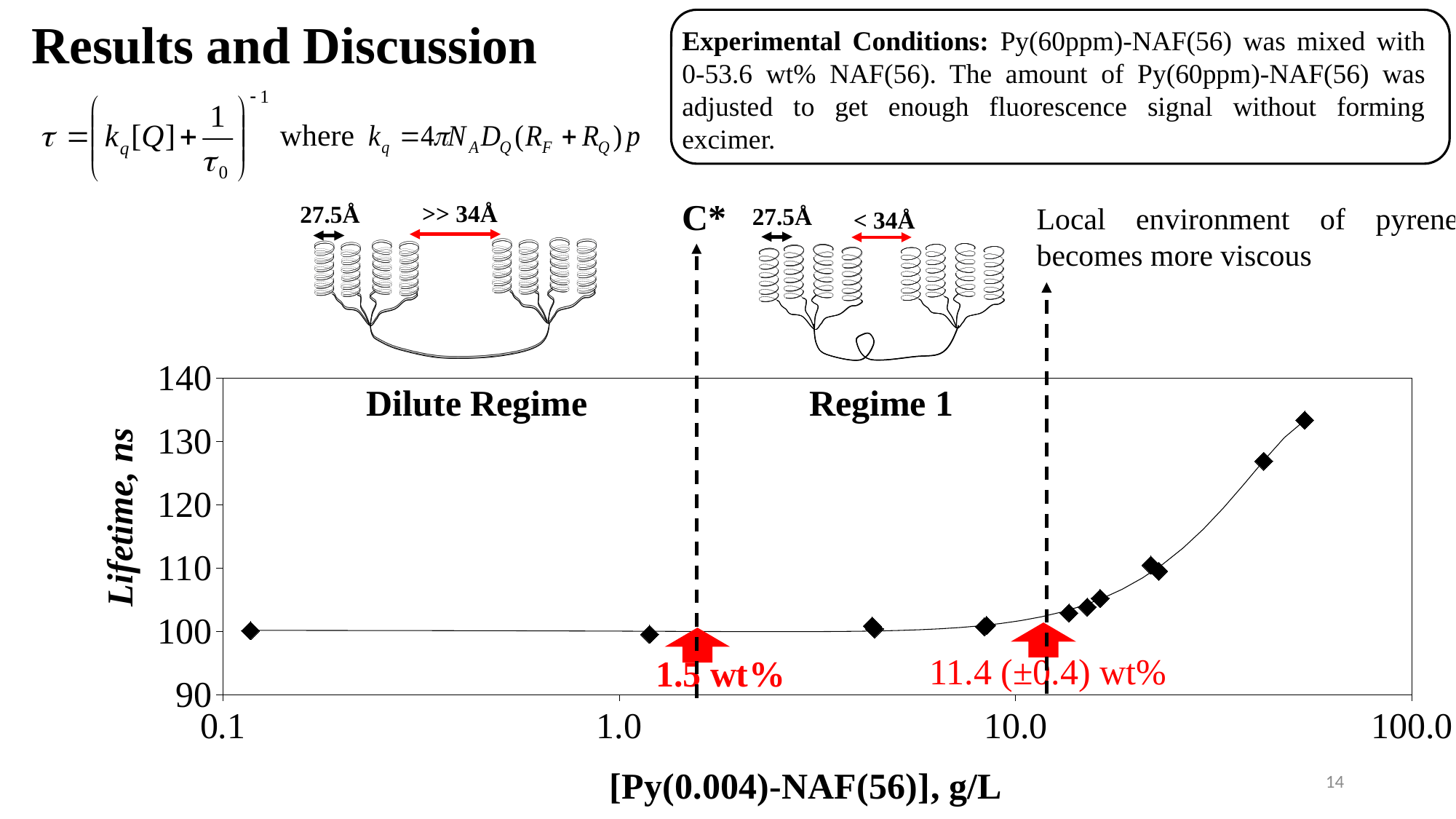
Does the lifetime rise or fall as the concentration increases beyond about 10 g/L? rise Is the lifetime at the second-highest concentration point greater or less than 120 ns? greater What is the highest value shown on the x axis of the chart? 100.0 What is the lowest value shown on the y axis of the chart? 90 Is the lifetime at the point just above 1.0 g/L greater or less than 110 ns? less Is the lifetime at the highest plotted concentration greater or less than 130 ns? greater What are the two regimes labelled on the chart? Dilute Regime and Regime 1 What kind of chart is shown on the slide? Scatter (line) chart Which has the larger lifetime: the point at about 0.1 g/L or the point at the highest concentration? the point at the highest concentration What is the label of the y axis of the chart? Lifetime, ns Does the lifetime reach its maximum at the lowest or the highest concentration plotted? highest